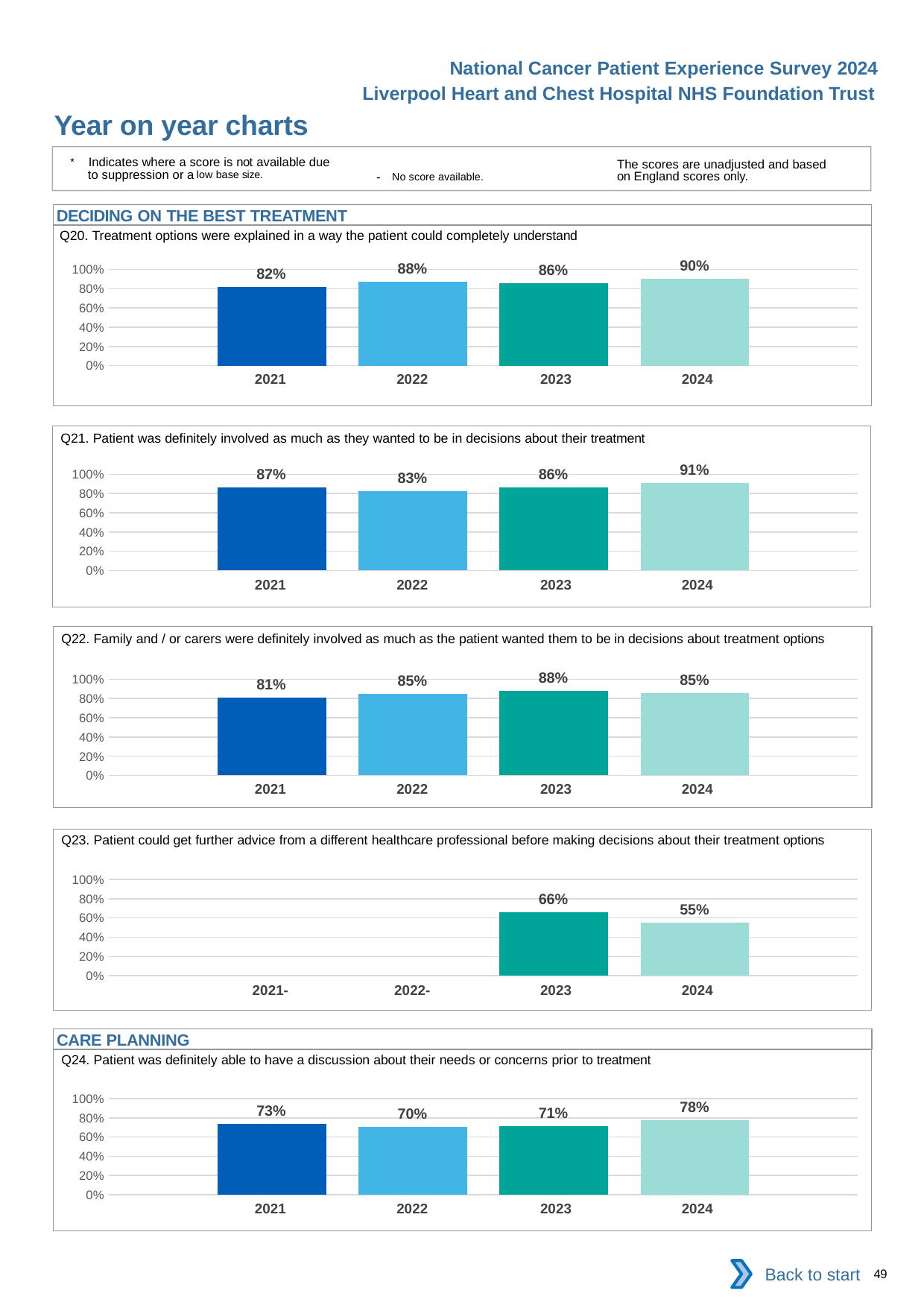
In the Q22 chart, which year has the highest value? 2023 In the Q24 chart, what is the difference between the 2024 and 2021 values? 5% In the Q23 chart, what is the difference between the 2023 and 2024 values? 11% In the Q20 chart, what is the value for 2021? 82% In the Q23 chart, is the value for 2024 greater or less than 60%? less In the Q24 chart, which is larger, the value for 2021 or the value for 2022? 2021 In the Q22 chart, what is the value for 2022? 85% In the Q23 chart, how many years have a score shown? 2 How many charts are shown on the slide? 5 In the Q20 chart, what is the value for 2024? 90% In the Q21 chart, which year has the lowest value? 2022 What kind of chart is the Q21 chart? bar chart